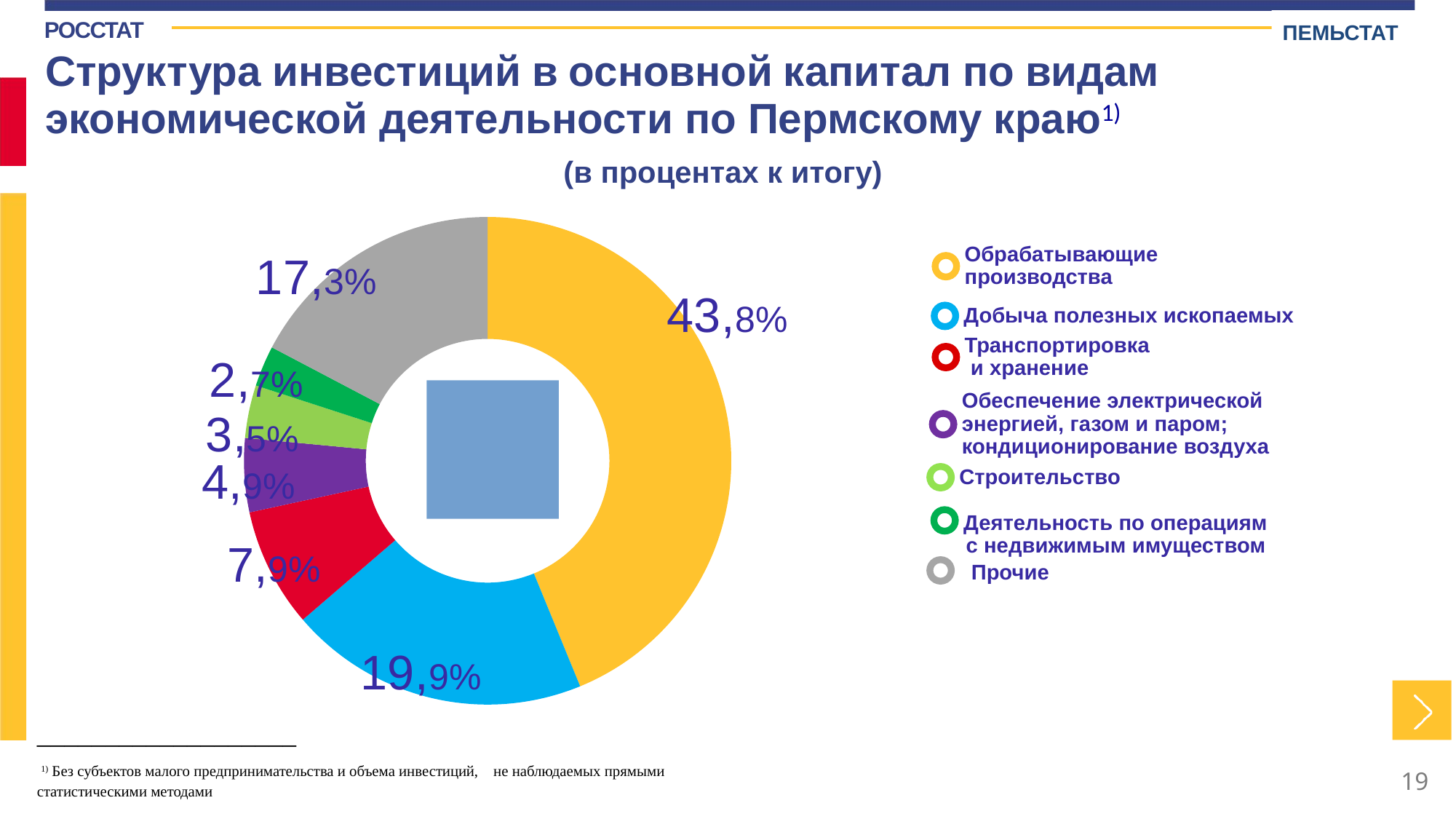
Что больше: доля прочих видов деятельности или доля транспортировки и хранения? Прочие Какая доля инвестиций приходится на добычу полезных ископаемых? 19,9% Какая доля инвестиций приходится на строительство? 3,5% Сколько категорий показано на диаграмме? 7 Какая доля инвестиций приходится на прочие виды деятельности? 17,3% Какой вид экономической деятельности имеет наибольшую долю инвестиций? Обрабатывающие производства Какая доля инвестиций приходится на деятельность по операциям с недвижимым имуществом? 2,7% Какая доля инвестиций приходится на обрабатывающие производства? 43,8% Какая доля инвестиций приходится на транспортировку и хранение? 7,9% Какой вид экономической деятельности имеет наименьшую долю инвестиций? Деятельность по операциям с недвижимым имуществом На сколько процентных пунктов доля обрабатывающих производств больше доли добычи полезных ископаемых? 23,9 Какого типа эта диаграмма? Кольцевая (круговая) диаграмма